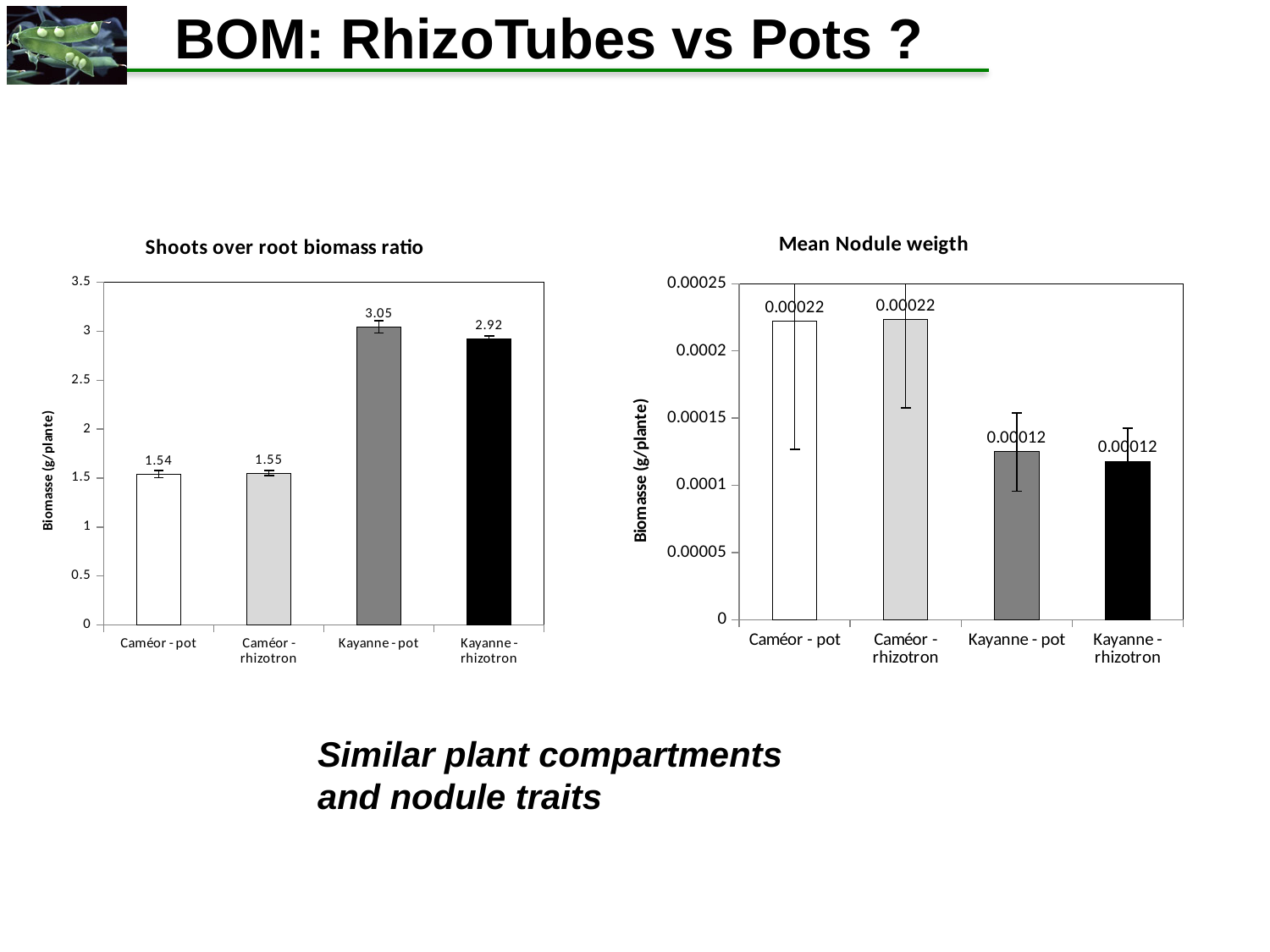
What is the y-axis label of the 'Mean Nodule weigth' chart? Biomasse (g/plante) In the 'Shoots over root biomass ratio' chart, what is the difference between Kayanne - pot and Caméor - pot? 1.51 What kind of chart is the 'Mean Nodule weigth' chart? Bar chart In the 'Mean Nodule weigth' chart, what is the difference between Caméor - pot and Kayanne - pot? 0.0001 In the 'Mean Nodule weigth' chart, what is the value for Caméor - rhizotron? 0.00022 In the 'Shoots over root biomass ratio' chart, which category has the highest value? Kayanne - pot In the 'Mean Nodule weigth' chart, what is the value for Kayanne - rhizotron? 0.00012 In the 'Shoots over root biomass ratio' chart, what is the value for Caméor - rhizotron? 1.55 In the 'Shoots over root biomass ratio' chart, which is larger: Kayanne - pot or Kayanne - rhizotron? Kayanne - pot In the 'Shoots over root biomass ratio' chart, what is the value for Kayanne - pot? 3.05 In the 'Shoots over root biomass ratio' chart, how many categories are shown? 4 In the 'Mean Nodule weigth' chart, is the value for Kayanne - pot greater or less than 0.00015? less